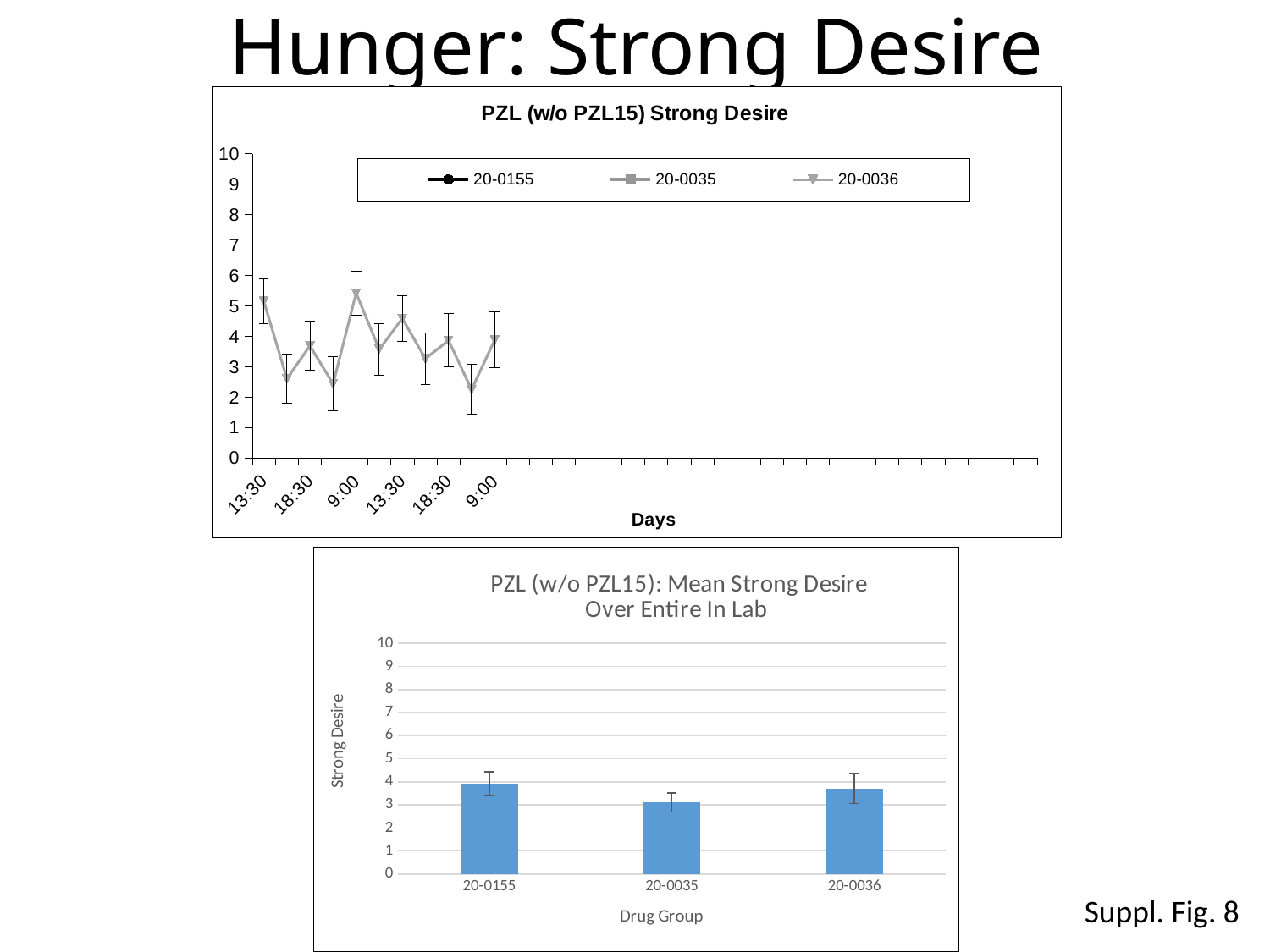
In the bottom bar chart, is the value for 20-0035 greater or less than 4? less In the bottom bar chart, is the value for 20-0155 greater or less than 3? greater What kind of chart is the top chart titled "PZL (w/o PZL15) Strong Desire"? line chart What kind of chart is the bottom chart titled "PZL (w/o PZL15): Mean Strong Desire Over Entire In Lab"? bar chart In the bottom bar chart, which drug group has the lowest mean strong desire? 20-0035 What is the x-axis title of the top line chart? Days How many series does the legend of the top chart "PZL (w/o PZL15) Strong Desire" list? 3 In the bottom bar chart, is the value for 20-0036 greater or less than 5? less What is the x-axis title of the bottom bar chart? Drug Group How many drug groups are shown on the x axis of the bottom bar chart? 3 In the bottom bar chart, which is larger, the value for 20-0155 or the value for 20-0035? 20-0155